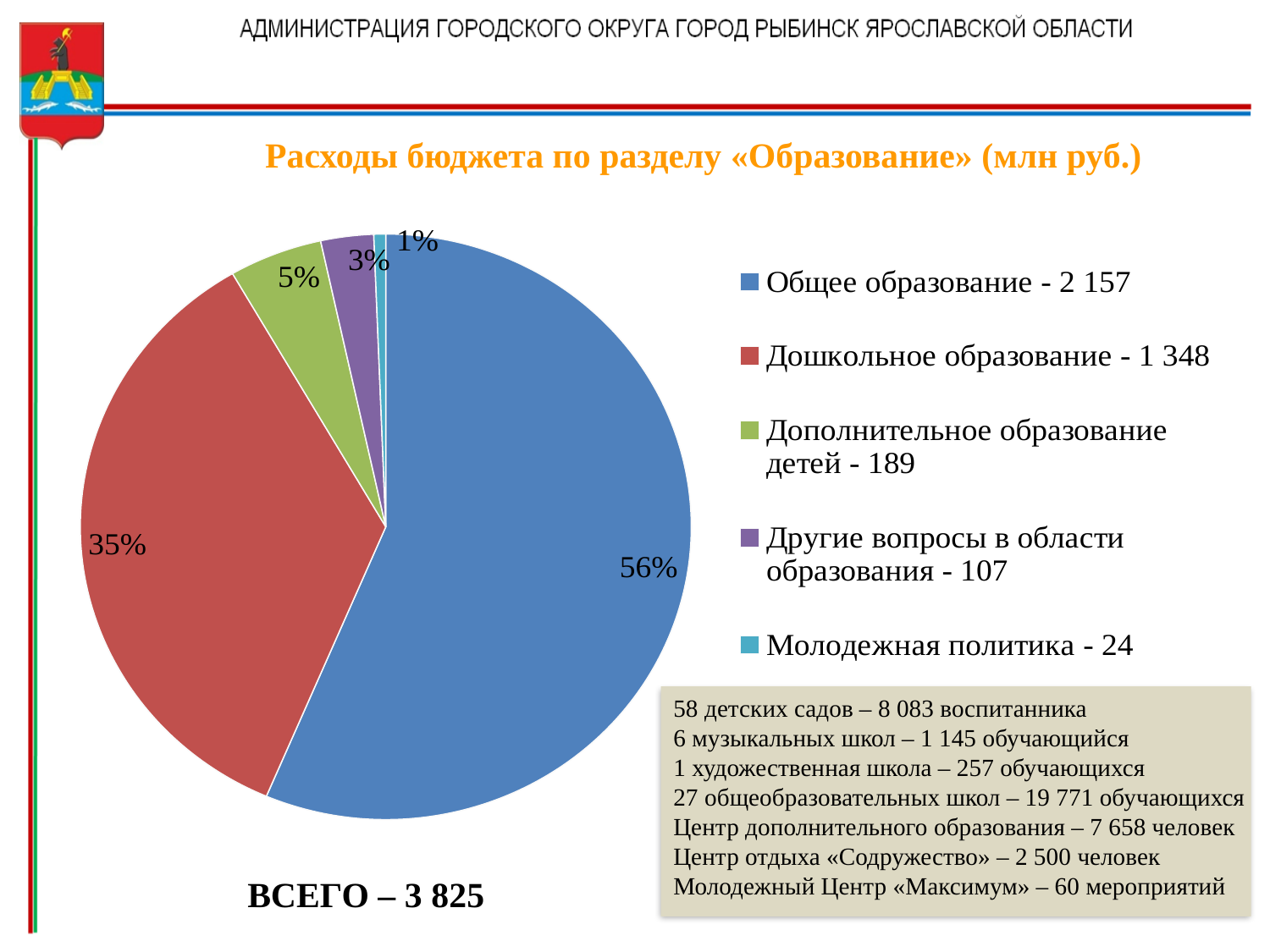
What share of the pie does «Дополнительное образование детей» take? 5% What value is given in the legend for «Молодежная политика»? 24 How many slices does the pie chart have? 5 What share of the pie does «Общее образование» take? 56% How many entries does the legend list? 5 Which category has the smallest slice of the pie? Молодежная политика What value is given in the legend for «Другие вопросы в области образования»? 107 What kind of chart is shown on the slide? pie chart Which category has the largest slice of the pie? Общее образование Which is larger: «Дополнительное образование детей» or «Другие вопросы в области образования»? Дополнительное образование детей What is the difference between the values for «Общее образование» and «Дошкольное образование»? 809 What share of the pie does «Дошкольное образование» take? 35%